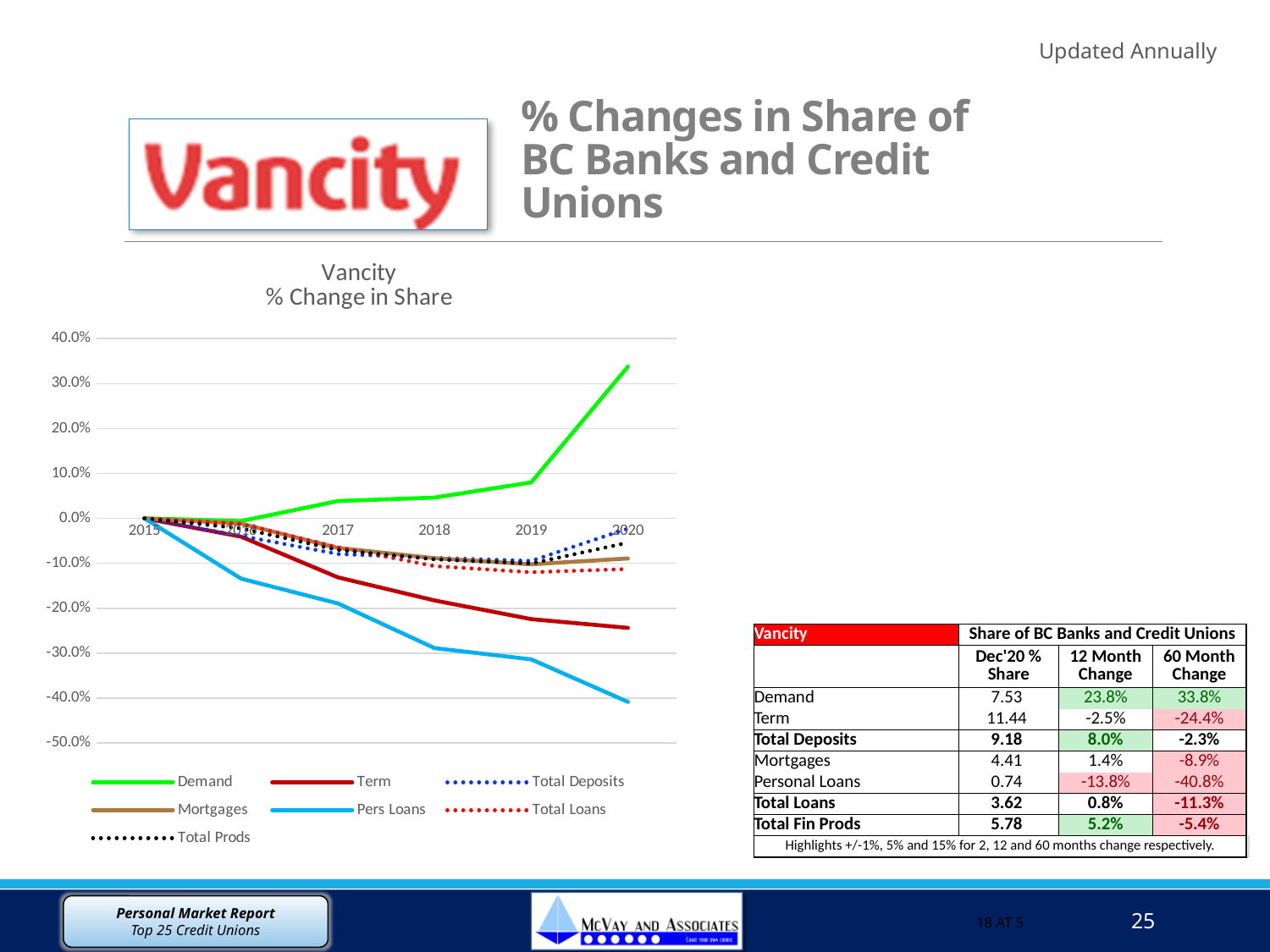
How many years are shown on the x axis of the 'Vancity % Change in Share' chart? 6 Which series has the highest value in 2020 on the 'Vancity % Change in Share' chart? Demand On the 'Vancity % Change in Share' chart, is the value for Pers Loans in 2020 greater or less than -30.0%? less On the 'Vancity % Change in Share' chart, is the value for Term in 2020 greater or less than -20.0%? less On the 'Vancity % Change in Share' chart, which is larger in 2020: Demand or Term? Demand What colour is the Demand line on the 'Vancity % Change in Share' chart? green On the 'Vancity % Change in Share' chart, is the value for Demand in 2020 greater or less than 30.0%? greater What kind of chart is the 'Vancity % Change in Share' chart? line chart On the 'Vancity % Change in Share' chart, does the Demand series rise or fall from 2015 to 2020? rises Which series has the lowest value in 2020 on the 'Vancity % Change in Share' chart? Pers Loans On the 'Vancity % Change in Share' chart, does the Pers Loans series rise or fall from 2015 to 2020? falls How many series does the legend of the 'Vancity % Change in Share' chart list? 7